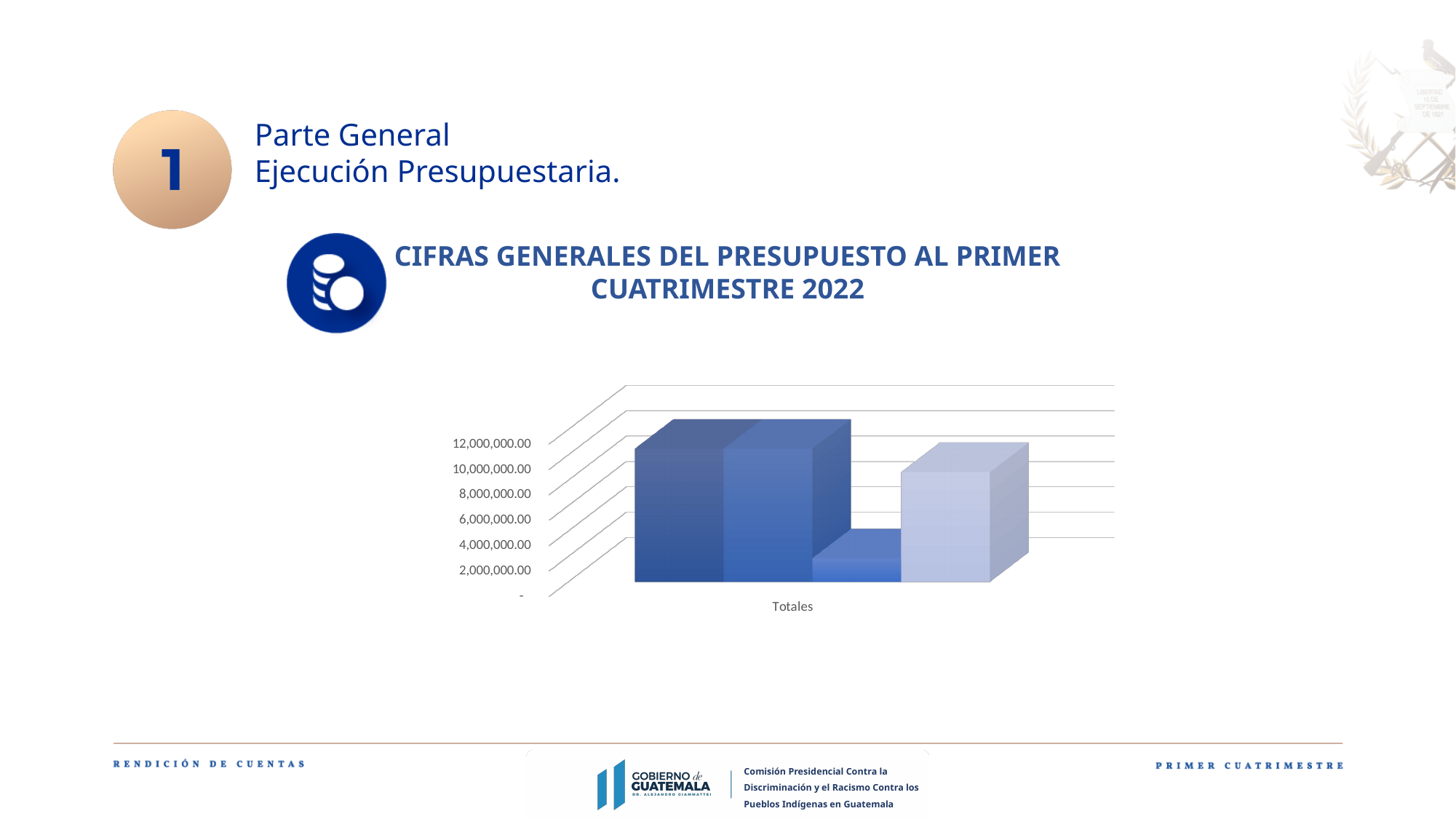
What kind of chart is shown on the slide? bar chart How many categories are shown on the x axis of the chart? 1 How many bars are plotted in the chart? 4 Which is larger in the chart, the leftmost bar or the rightmost bar? the leftmost bar Is the value of the leftmost bar in the chart greater or less than 10,000,000.00? greater What is the label of the category on the x axis of the chart? Totales Is the value of the rightmost bar in the chart greater or less than 8,000,000.00? greater What is the highest value labelled on the vertical axis of the chart? 12,000,000.00